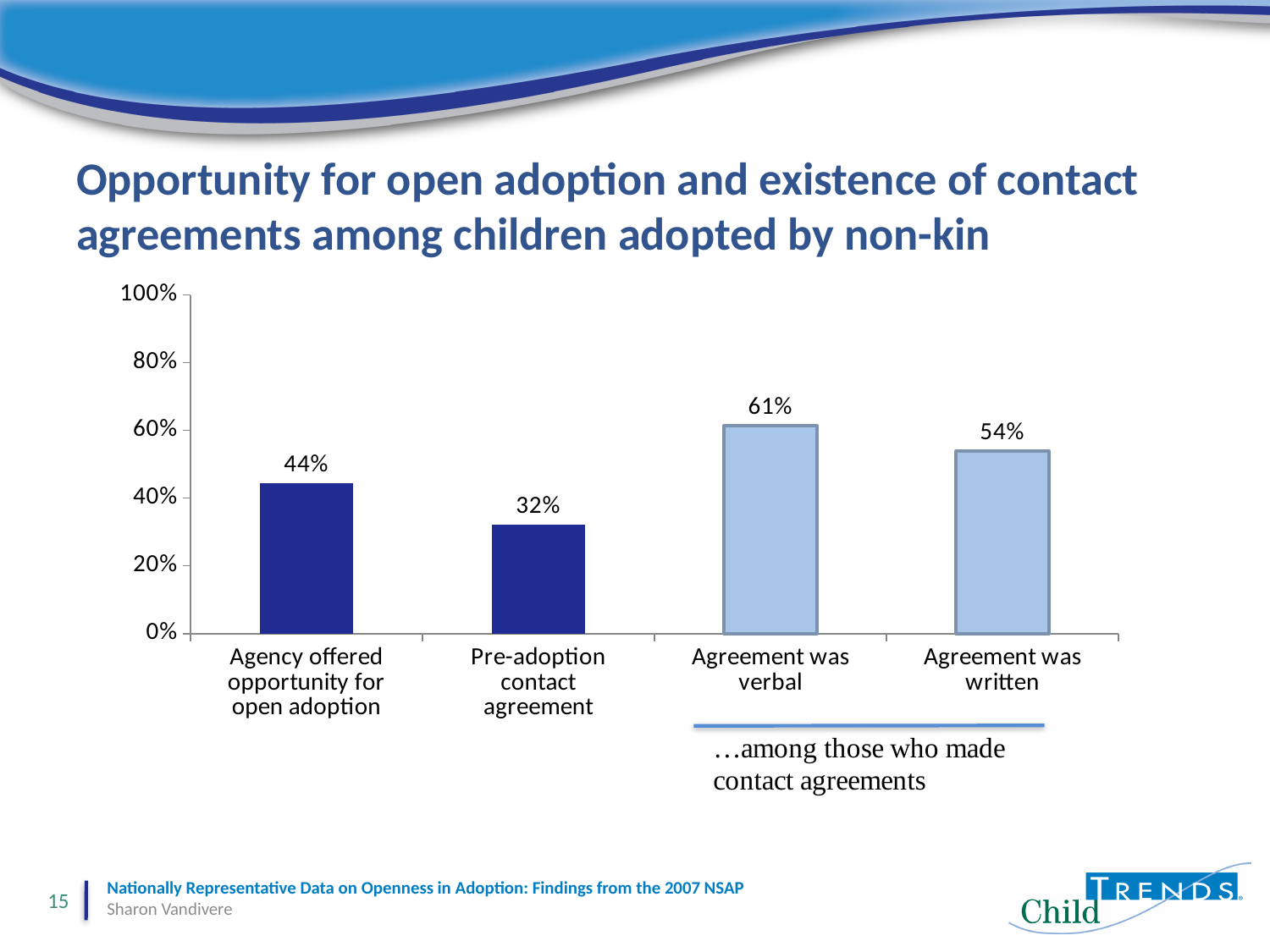
What is the value for "Agreement was verbal"? 61% Which is larger: the value for "Agreement was written" or the value for "Agency offered opportunity for open adoption"? Agreement was written What is the difference between the values for "Agreement was verbal" and "Agreement was written"? 7% What is the difference between the values for "Agency offered opportunity for open adoption" and "Pre-adoption contact agreement"? 12% What is the value for "Agreement was written"? 54% Which category has the highest value? Agreement was verbal How many categories are shown in the chart? 4 What is the value for "Agency offered opportunity for open adoption"? 44% What is the value for "Pre-adoption contact agreement"? 32% What kind of chart is shown on the slide? Bar chart Is the value for "Agreement was verbal" greater or less than 60%? greater Which category has the lowest value? Pre-adoption contact agreement